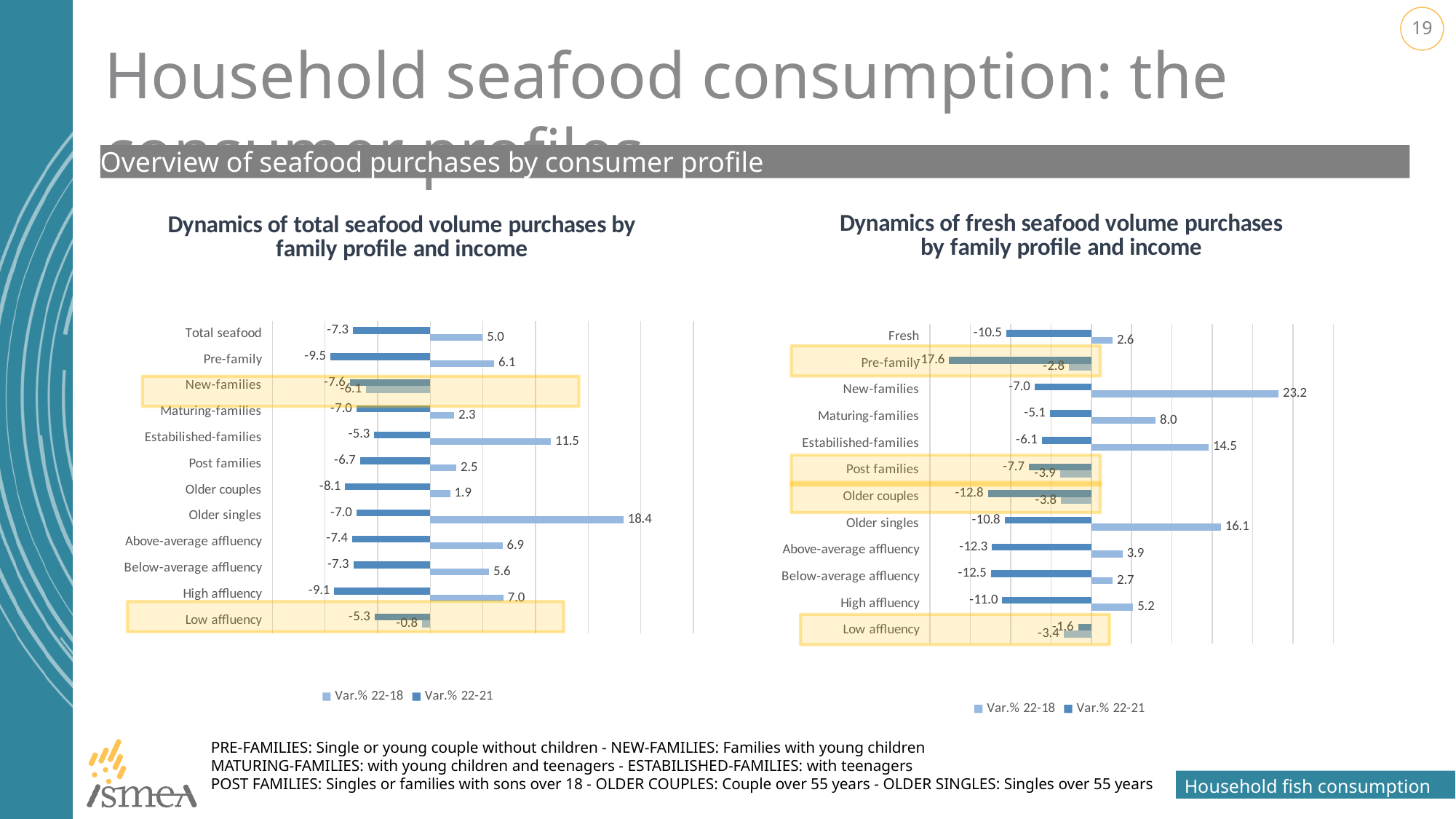
What type of chart is the 'Dynamics of total seafood volume purchases by family profile and income' chart? Bar chart How many series does the legend list in the 'Dynamics of total seafood volume purchases by family profile and income' chart? 2 In the 'Dynamics of fresh seafood volume purchases by family profile and income' chart, what is the difference between the Var.% 22-18 values for New-families and Established-families? 8.7 How many categories are shown in the 'Dynamics of fresh seafood volume purchases by family profile and income' chart? 12 In the 'Dynamics of fresh seafood volume purchases by family profile and income' chart, what is the Var.% 22-18 value for New-families? 23.2 In the 'Dynamics of fresh seafood volume purchases by family profile and income' chart, which category has the lowest Var.% 22-21 value? Pre-family In the 'Dynamics of total seafood volume purchases by family profile and income' chart, what is the Var.% 22-21 value for Pre-family? -9.5 What are the two series named in the legend of the 'Dynamics of fresh seafood volume purchases by family profile and income' chart? Var.% 22-18 and Var.% 22-21 In the 'Dynamics of total seafood volume purchases by family profile and income' chart, what is the Var.% 22-18 value for Older singles? 18.4 In the 'Dynamics of total seafood volume purchases by family profile and income' chart, which category has the highest Var.% 22-18 value? Older singles In the 'Dynamics of fresh seafood volume purchases by family profile and income' chart, what is the Var.% 22-21 value for Older couples? -12.8 In the 'Dynamics of total seafood volume purchases by family profile and income' chart, which is larger: the Var.% 22-18 value for Established-families or for High affluency? Established-families